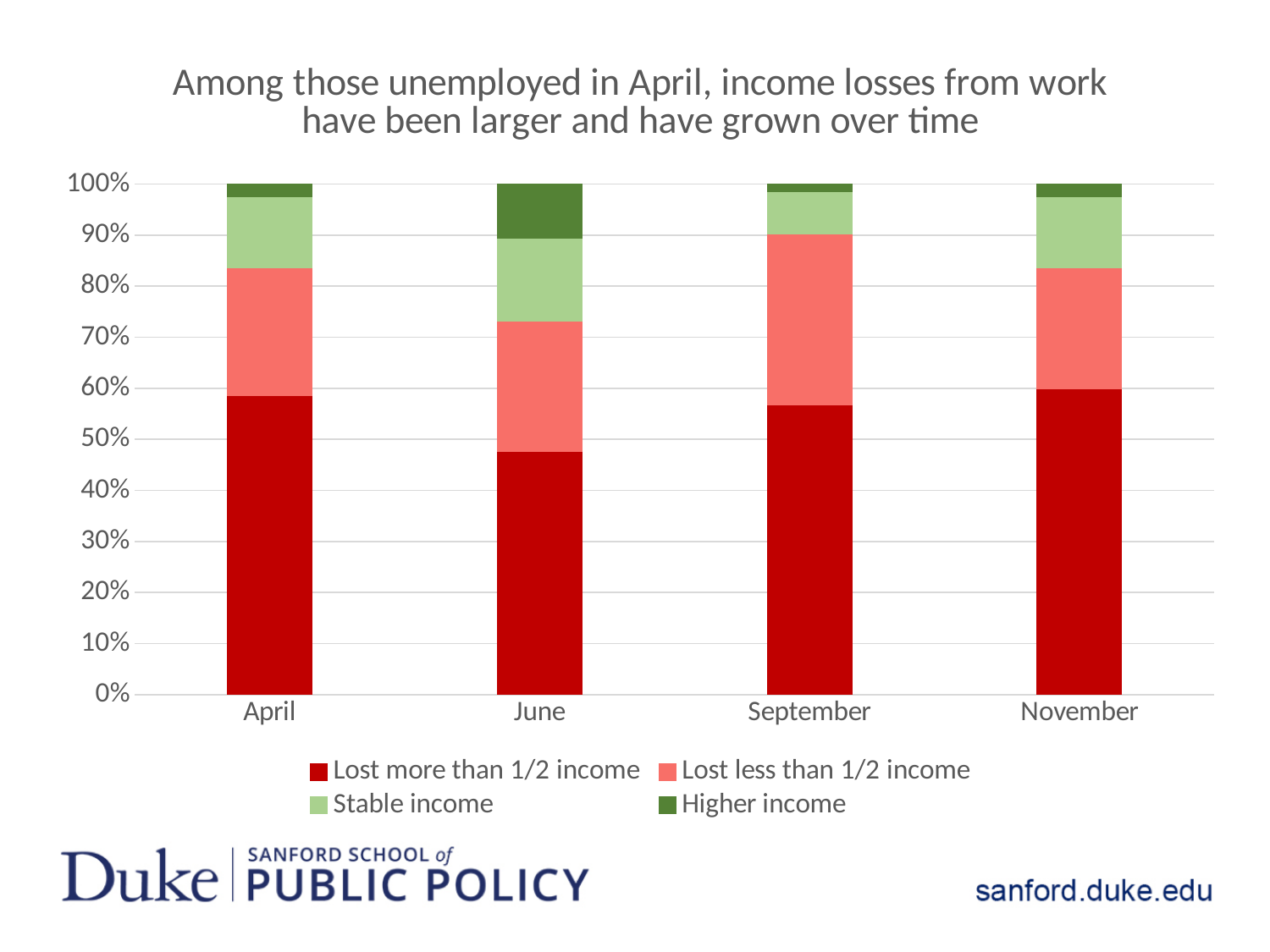
Is the 'Lost more than 1/2 income' share for June greater or less than 50%? less Which legend entry is shown in dark red? Lost more than 1/2 income Is the 'Lost more than 1/2 income' share for November greater or less than 50%? greater What kind of chart is shown on the slide? Stacked bar chart How many series does the chart's legend list? 4 How many months are shown on the x axis of the chart? 4 What is the total height of each stacked bar in the chart? 100% Which month has a larger 'Lost more than 1/2 income' share, June or September? September In which month is the 'Higher income' segment the largest? June In which month is the 'Lost more than 1/2 income' segment the smallest? June Is the 'Lost more than 1/2 income' share for April greater or less than 50%? greater In which month is the 'Stable income' segment the smallest? September